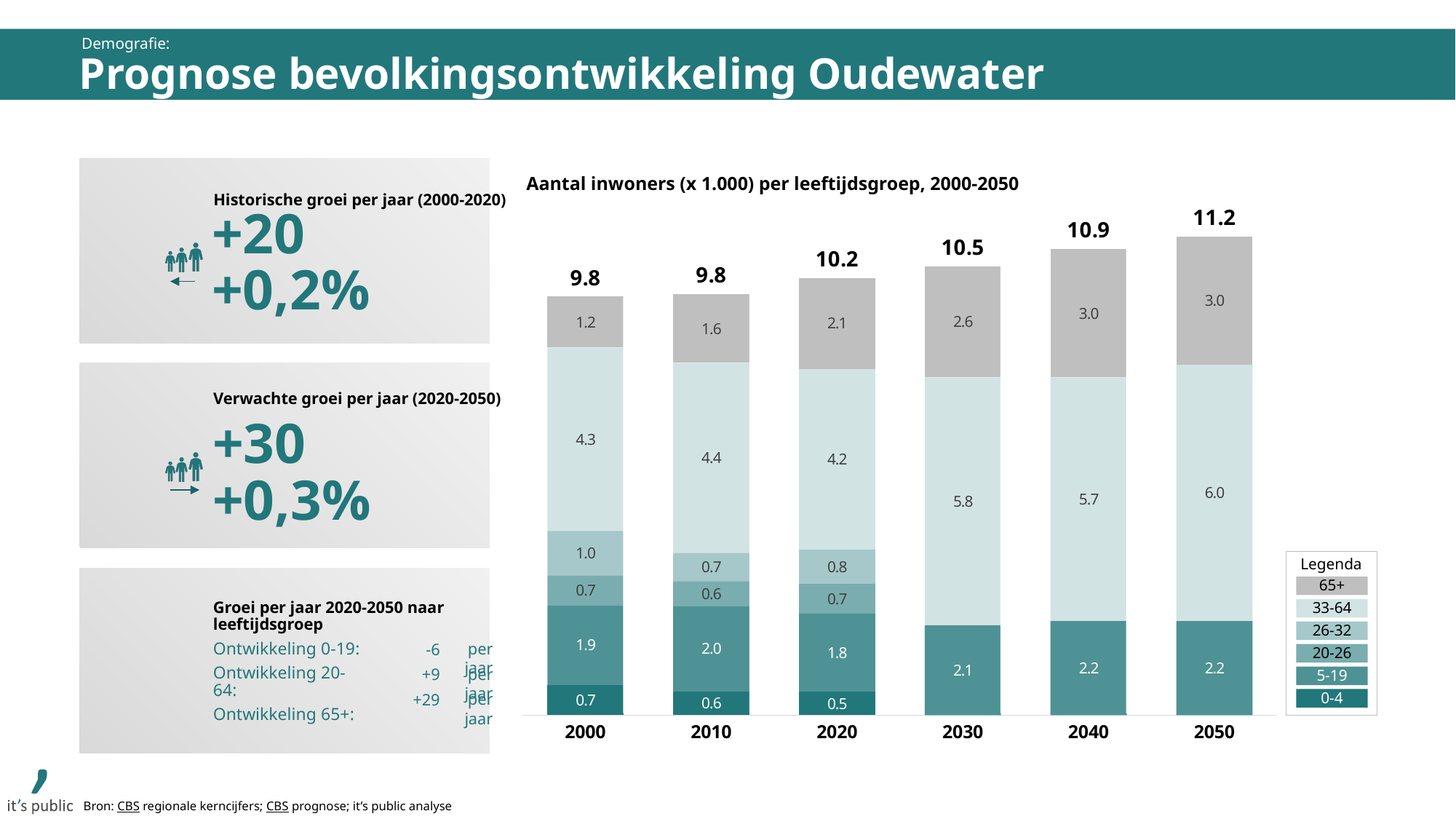
What is the value of the 0-4 segment for 2010? 0.6 How many years are shown on the x axis? 6 Does the total number of inhabitants rise or fall from 2020 to 2050? Rise What is the title of the chart? Aantal inwoners (x 1.000) per leeftijdsgroep, 2000-2050 What kind of chart is shown on the slide? Stacked bar chart What is the value of the 65+ segment for 2020? 2.1 What is the total number of inhabitants (x 1.000) shown for 2050? 11.2 Which is larger: the 33-64 segment in 2030 or the 33-64 segment in 2040? 2030 How many age groups does the legend list? 6 Which year has the highest total number of inhabitants? 2050 What is the value of the 33-64 segment for 2000? 4.3 What is the difference between the 65+ value in 2050 and the 65+ value in 2000? 1.8